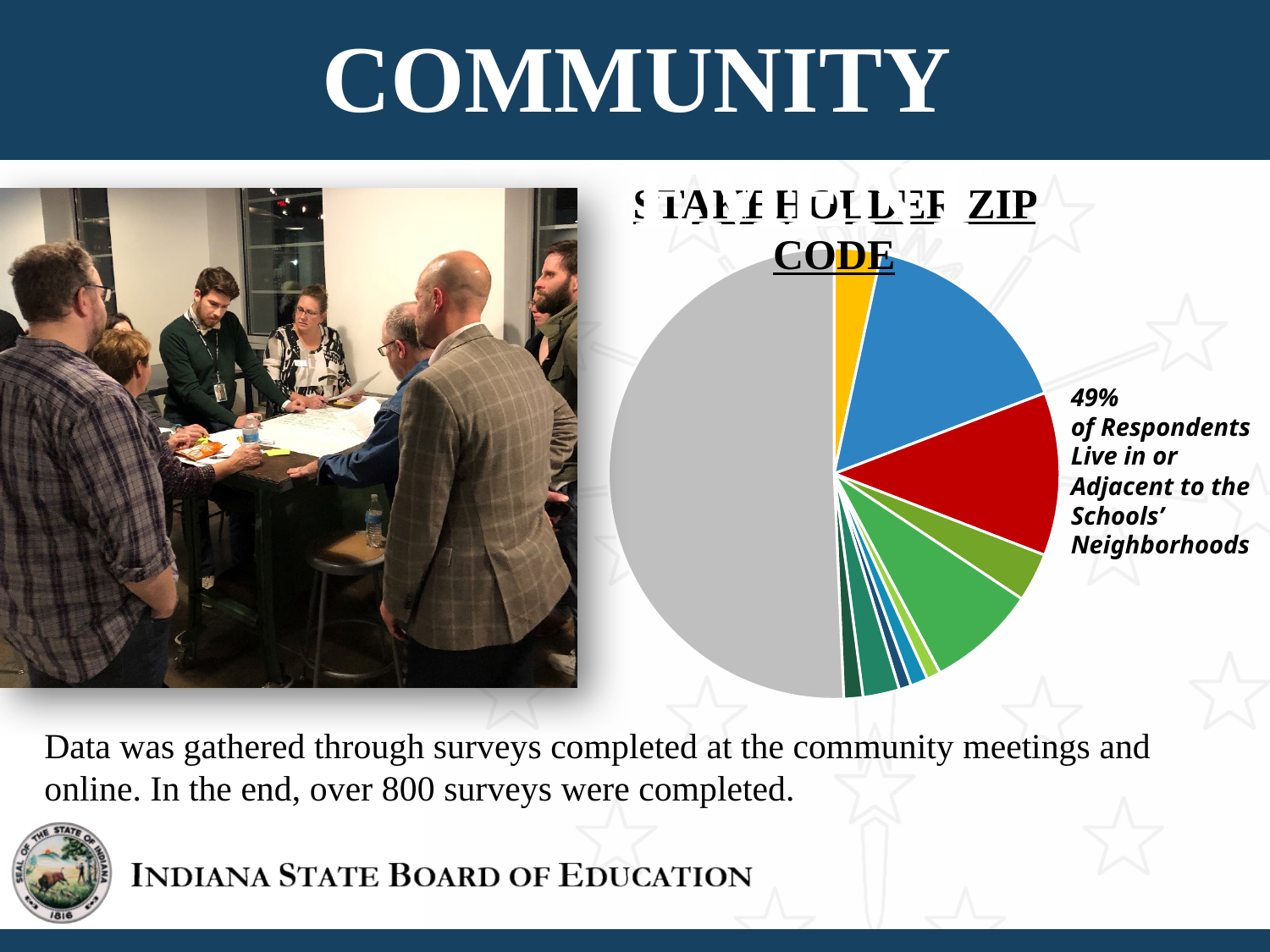
In the pie chart, which slice is larger, the yellow slice or the red slice? Red Does the pie chart include a legend identifying its slices? No Which colour slice is the largest in the pie chart? Gray In the pie chart, which slice is larger, the gray slice or the blue slice? Gray In the pie chart, which slice is larger, the blue slice or the red slice? Blue According to the text beside the pie chart, what percentage of respondents live in or adjacent to the schools' neighborhoods? 49% What kind of chart is shown on the slide? Pie chart